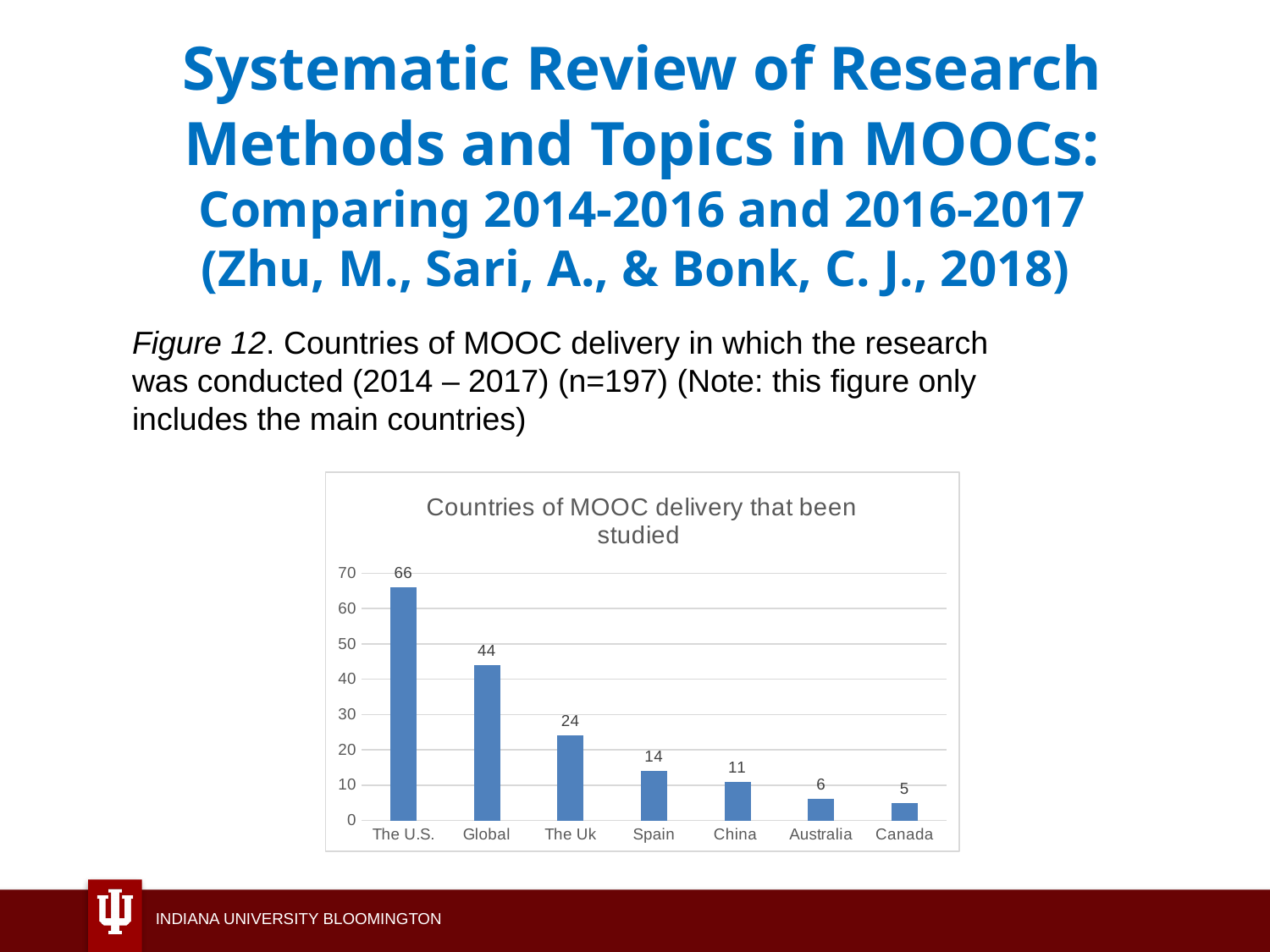
What is the difference between the values for The U.S. and Global? 22 Which category has the highest value? The U.S. What is the value for The U.S.? 66 What kind of chart is this? bar chart What is the value for Australia? 6 How many categories are shown on the x axis? 7 Is the value for Global greater or less than 40? greater What is the title of the chart? Countries of MOOC delivery that been studied What is the value for Spain? 14 Which is larger, the value for Spain or the value for China? Spain What is the difference between the values for The Uk and China? 13 Which category has the lowest value? Canada